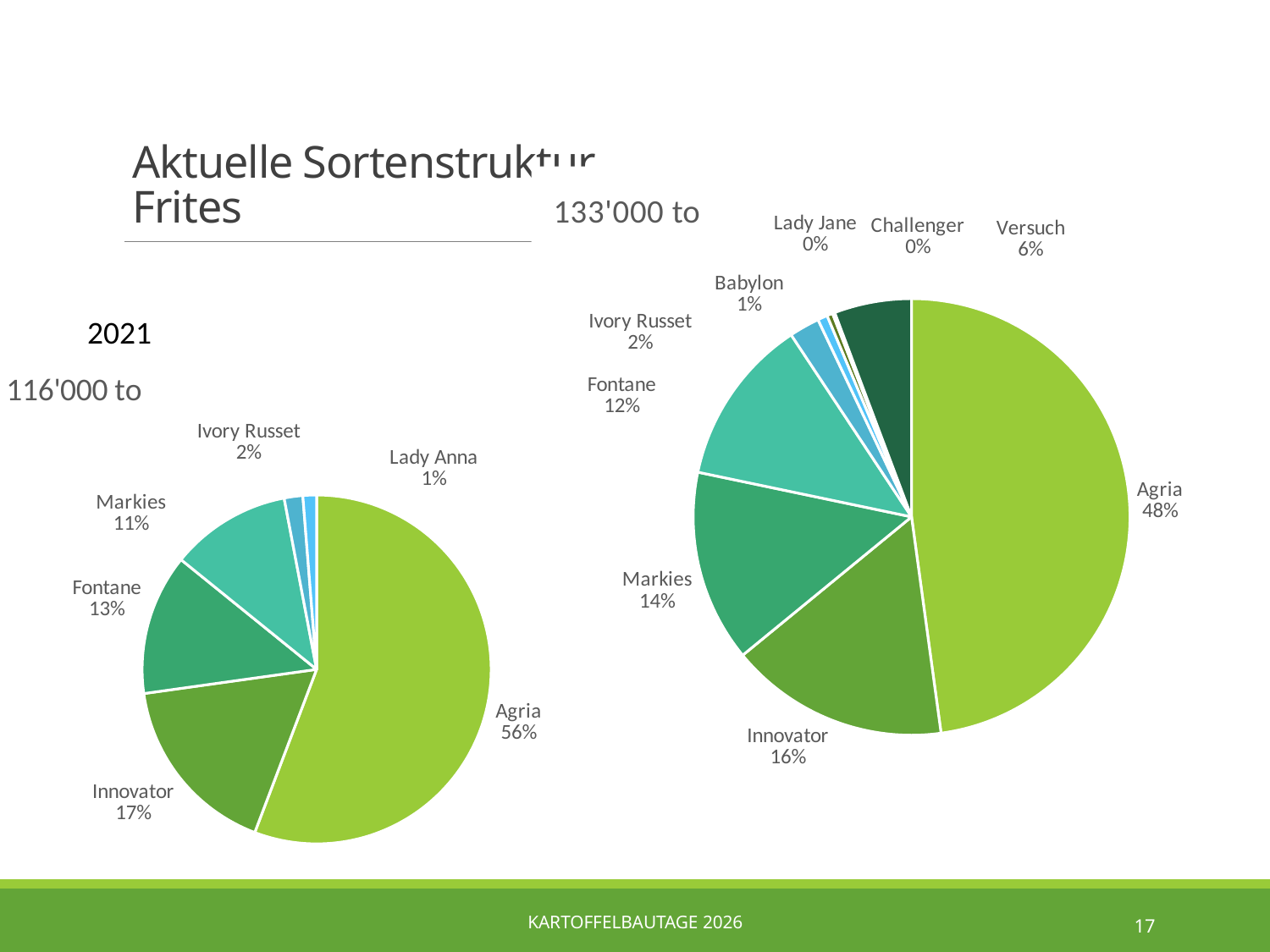
What type of chart is used on this slide? Pie chart In the left pie chart (2021), what is the share for Fontane? 13% What total tonnage is shown above the right pie chart? 133'000 to In the left pie chart (2021), what share does Agria have? 56% In the left pie chart (2021), which variety has the smallest share? Lady Anna How many varieties are labelled in the left pie chart (2021)? 6 In the right pie chart (133'000 to), what is the difference between the shares of Innovator and Markies? 2% In the left pie chart (2021), which variety has the largest share? Agria In the left pie chart (2021), which is larger, the share of Fontane or the share of Markies? Fontane In the right pie chart (133'000 to), what share does Agria have? 48% How many varieties are labelled in the right pie chart (133'000 to)? 9 In the right pie chart (133'000 to), what is the share for Versuch? 6%